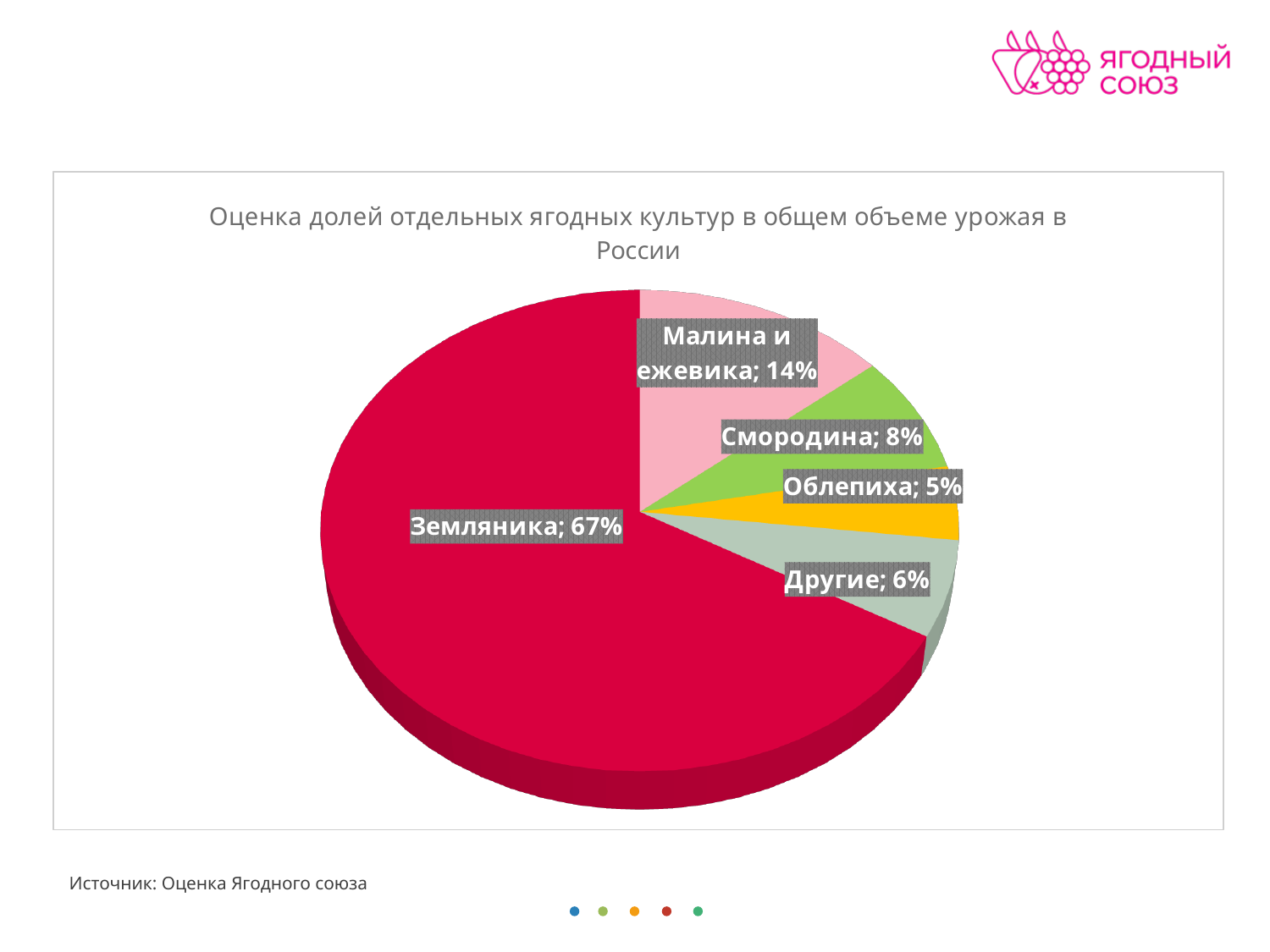
What kind of chart is shown on the slide? Pie chart What is the difference in percentage points between Земляника and Малина и ежевика? 53 Which berry crop has the smallest share of the harvest? Облепиха What share of the total berry harvest does Земляника account for? 67% What is the share for Другие? 6% Which berry crop has the largest share of the harvest? Земляника What is the title of the chart? Оценка долей отдельных ягодных культур в общем объеме урожая в России Which has a larger share, Смородина or Другие? Смородина What is the share for Малина и ежевика? 14% How many slices does the pie chart have? 5 What is the share for Смородина? 8% What is the share for Облепиха? 5%